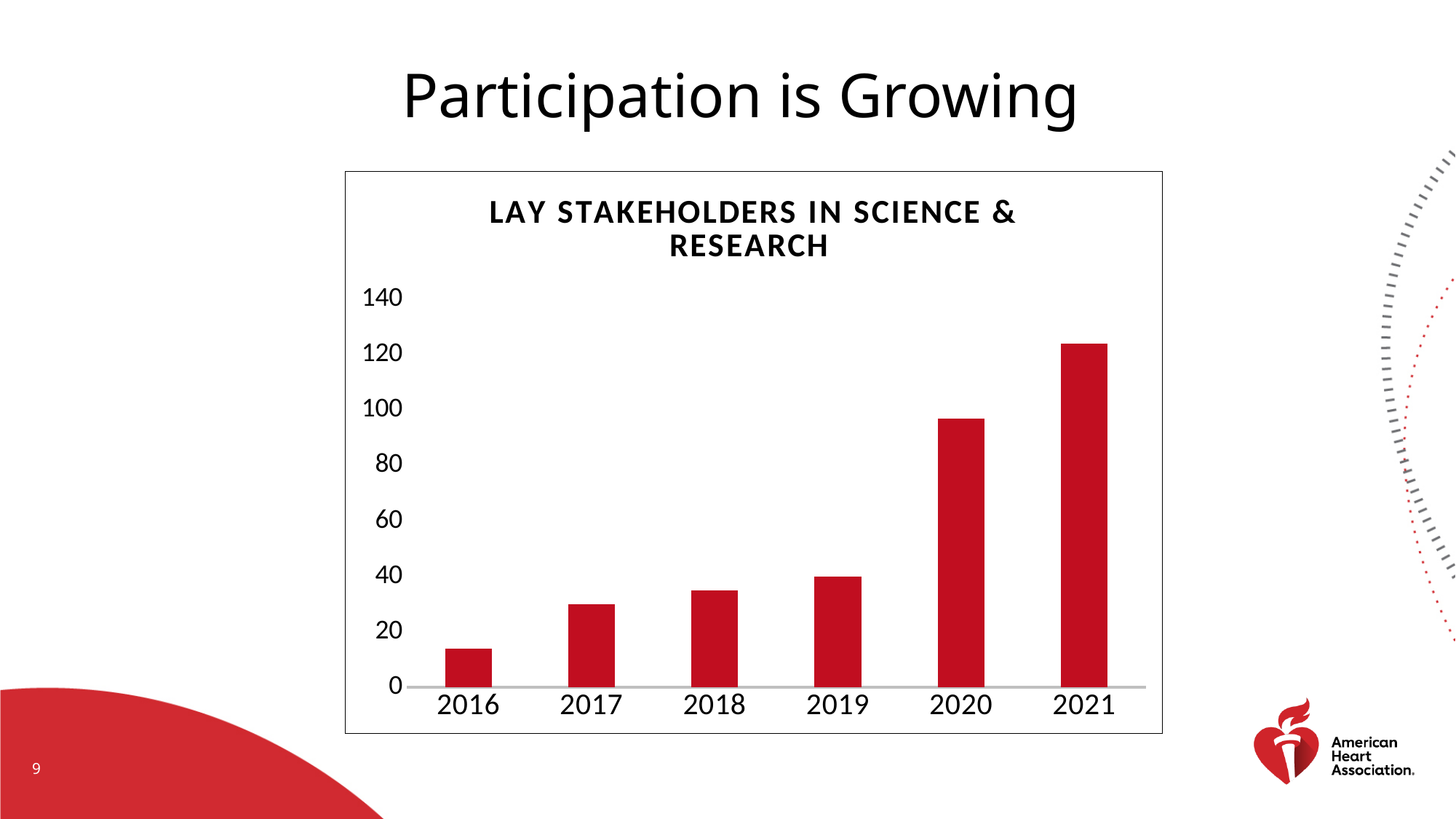
Which year has a larger value, 2019 or 2020? 2020 Is the value for 2017 greater or less than 20? greater Do the values rise or fall from 2016 to 2021? rise Is the value for 2018 greater or less than 40? less Is the value for 2021 greater or less than 100? greater Which year has the lowest number of lay stakeholders? 2016 How many years are shown on the x axis of the chart? 6 What is the title of the chart? LAY STAKEHOLDERS IN SCIENCE & RESEARCH What type of chart is shown on the slide? bar chart Which year has the highest number of lay stakeholders? 2021